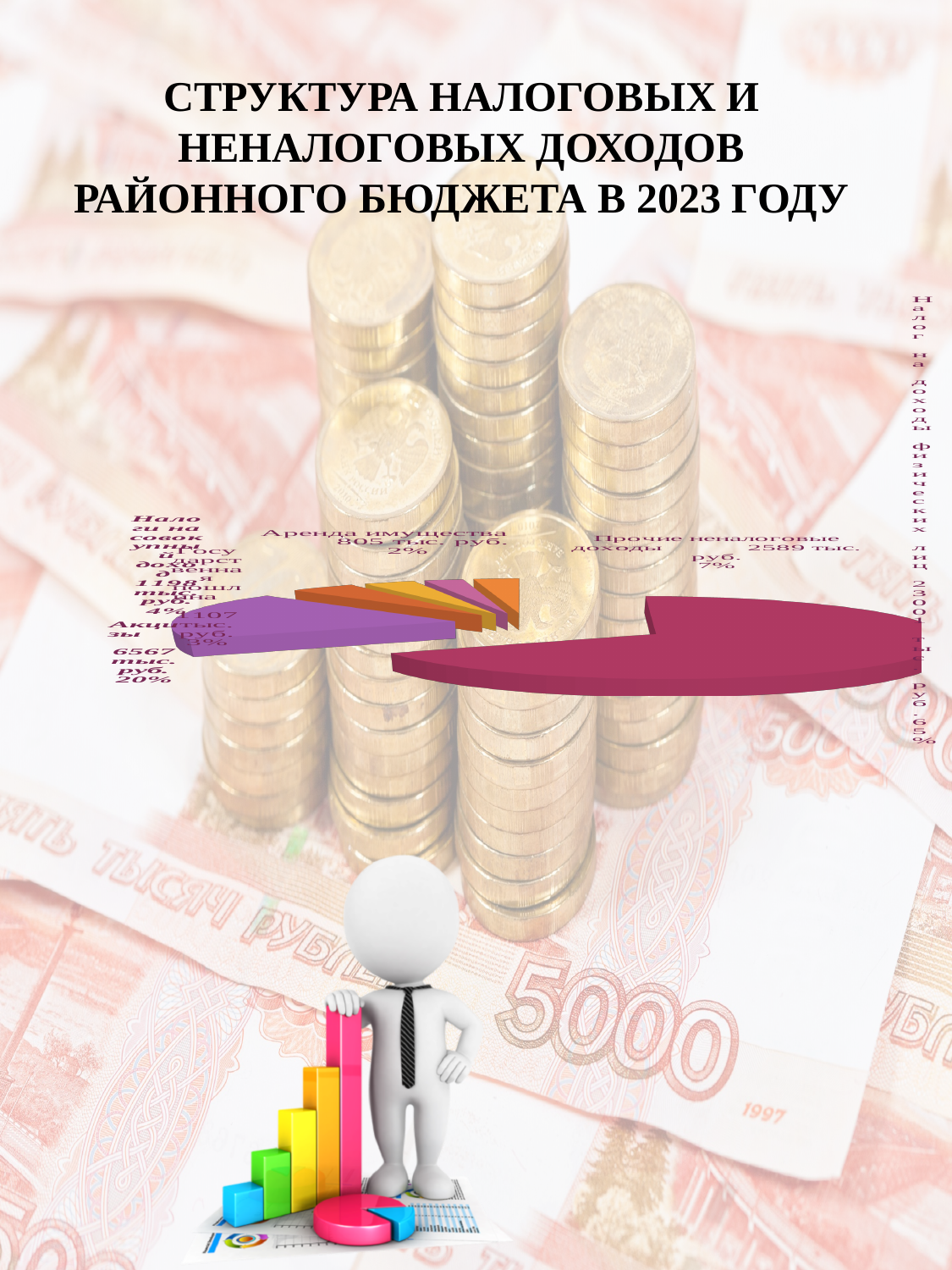
Which category has the largest slice of the pie? Налог на доходы физических лиц What kind of chart is shown on the slide? Pie chart What percentage of the pie is Прочие неналоговые доходы? 7% What share of the pie is Налоги на совокупный доход? 4% How many slices does the pie chart have? 6 Which category has the smallest slice of the pie? Аренда имущества What share of the pie does Акцизы account for? 20% What is the difference between the values for Прочие неналоговые доходы and Аренда имущества? 1784 тыс. руб. What is the title of the slide? Структура налоговых и неналоговых доходов районного бюджета в 2023 году What is the value shown for Прочие неналоговые доходы? 2589 тыс. руб. Which is larger, Акцизы or Прочие неналоговые доходы? Акцизы What is the value shown for Аренда имущества? 805 тыс. руб.